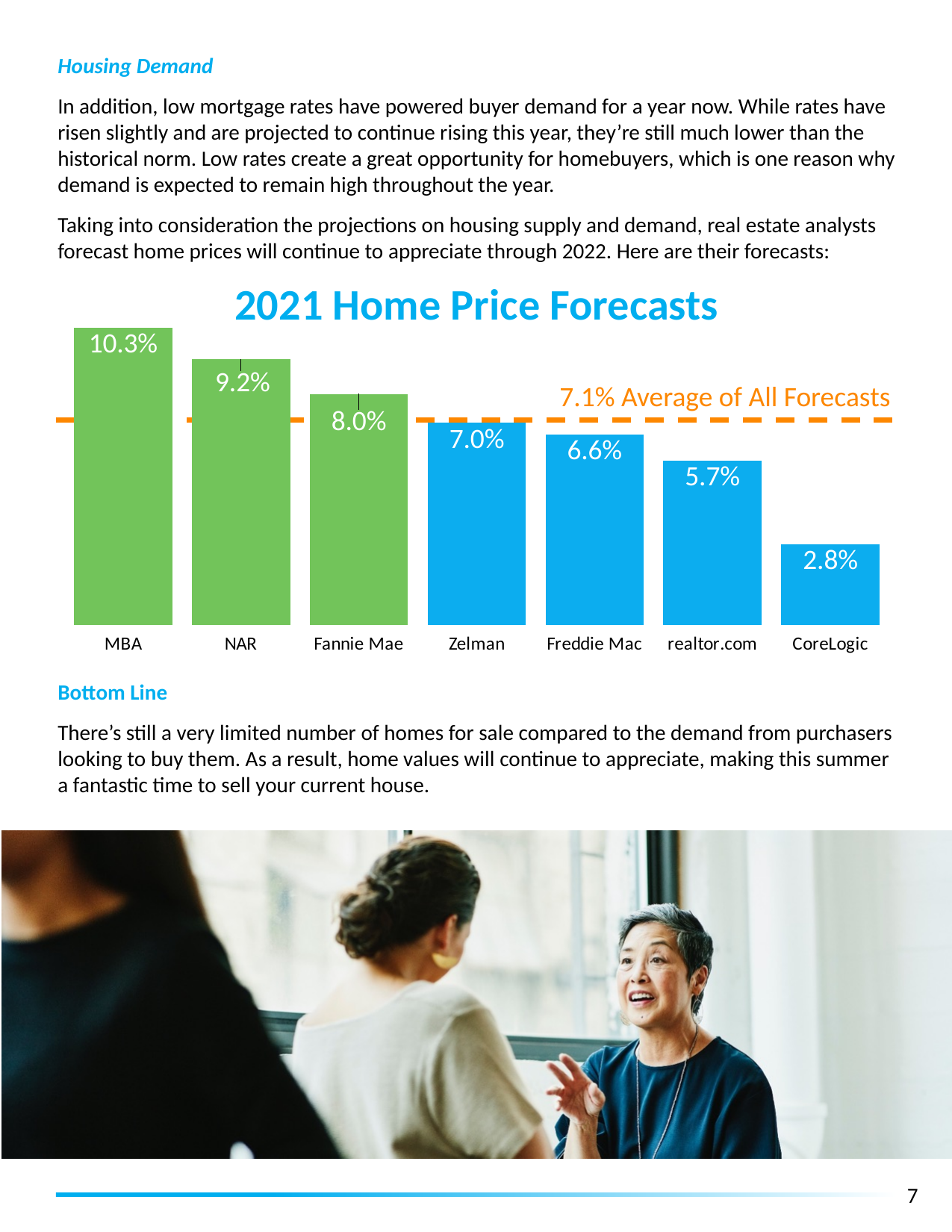
Which forecast is larger, Fannie Mae or realtor.com? Fannie Mae What is the 2021 home price forecast from CoreLogic? 2.8% What is the title of the chart? 2021 Home Price Forecasts What is the 2021 home price forecast from MBA? 10.3% Which forecaster has the highest 2021 home price forecast? MBA Do the forecast values rise or fall from left to right across the chart? Fall What is the 2021 home price forecast from Freddie Mac? 6.6% What kind of chart is shown on the slide? Bar chart What is the average of all forecasts shown by the dashed line? 7.1% What is the difference between the NAR forecast and the Zelman forecast? 2.2% Which forecaster has the lowest 2021 home price forecast? CoreLogic How many forecasters are shown in the chart? 7